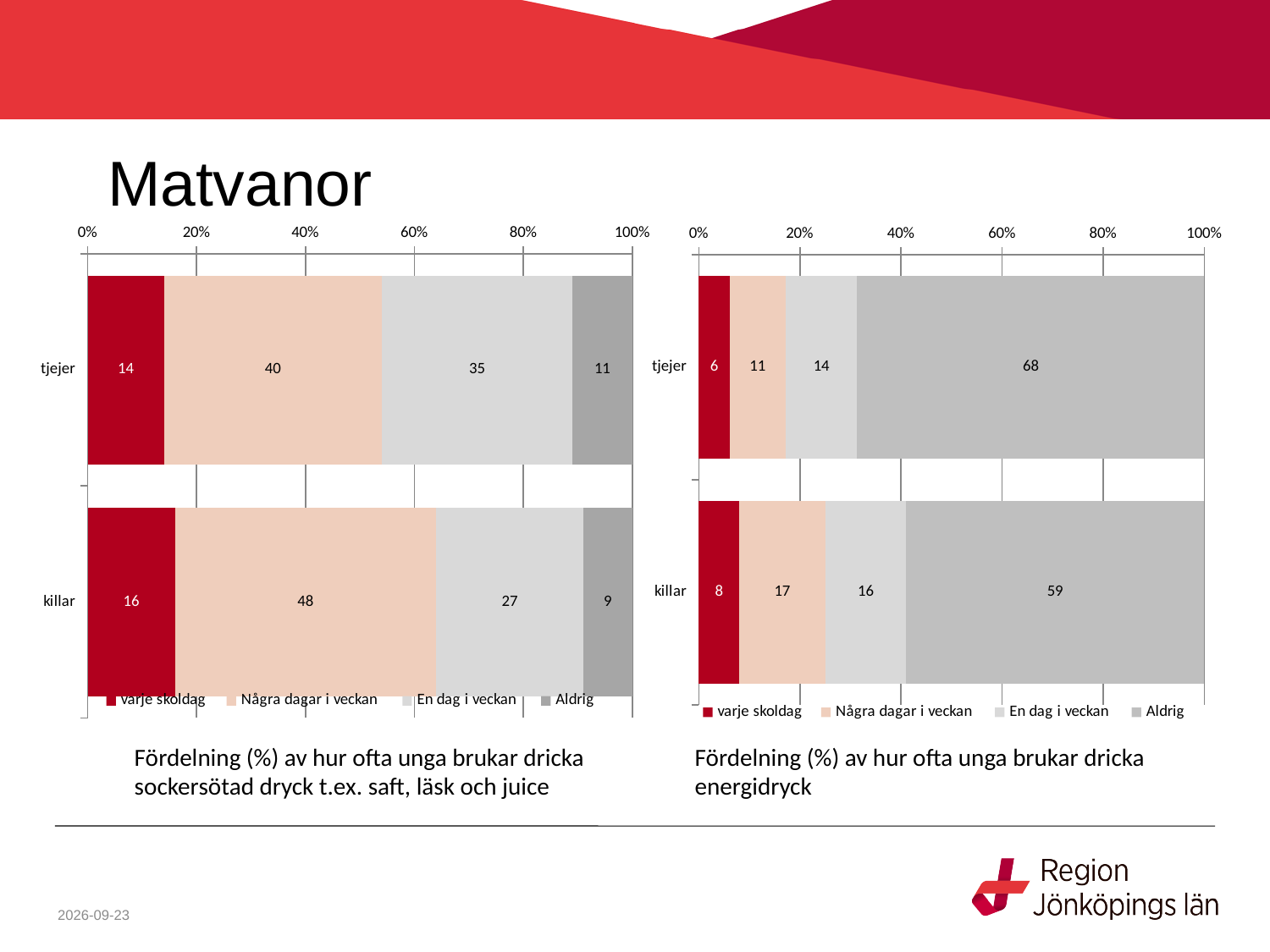
What kind of chart is the right chart (energidryck)? Stacked bar chart In the right chart (energidryck), what is the 'Aldrig' value for killar? 59 In the right chart (energidryck), what is the total of the stacked bar for killar? 100 In the left chart (sockersötad dryck), what is the difference between the 'En dag i veckan' values for tjejer and killar? 8 How many series does the legend of the left chart list? 4 In the right chart (energidryck), which segment is smallest for tjejer? varje skoldag In the left chart (sockersötad dryck), what percentage of tjejer drink sugary drinks 'Några dagar i veckan'? 40 What is the caption below the left chart? Fördelning (%) av hur ofta unga brukar dricka sockersötad dryck t.ex. saft, läsk och juice In the right chart (energidryck), which group has the higher 'Aldrig' value, tjejer or killar? tjejer How many categories (groups) are shown on the y axis of the right chart? 2 In the right chart (energidryck), what is the 'varje skoldag' value for tjejer? 6 In the left chart (sockersötad dryck), which segment is largest for killar? Några dagar i veckan